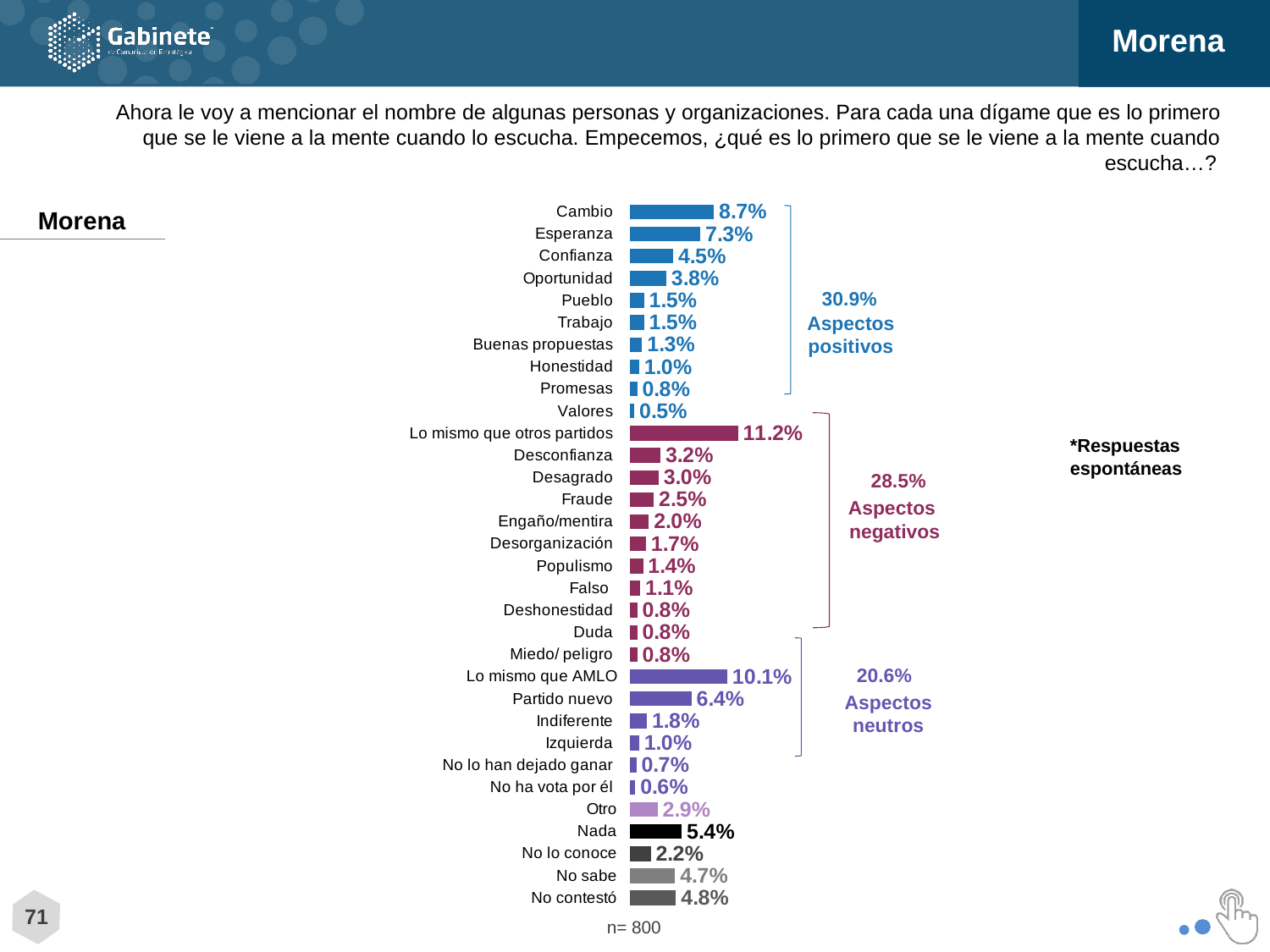
What percentage is given for the group labelled "Aspectos negativos"? 28.5% How many categories are plotted in the chart? 32 What is the value for "No contestó"? 4.8% What is the value for "Cambio"? 8.7% Which category has the lowest value? Valores Which is larger, the value for "Desconfianza" or the value for "Fraude"? Desconfianza What is the difference between the values for "Cambio" and "Esperanza"? 1.4 percentage points What is the value for "Lo mismo que AMLO"? 10.1% What kind of chart is shown on the slide? Bar chart What is the value for "Partido nuevo"? 6.4% Which category has the highest value? Lo mismo que otros partidos What sample size (n) is shown below the chart? n= 800